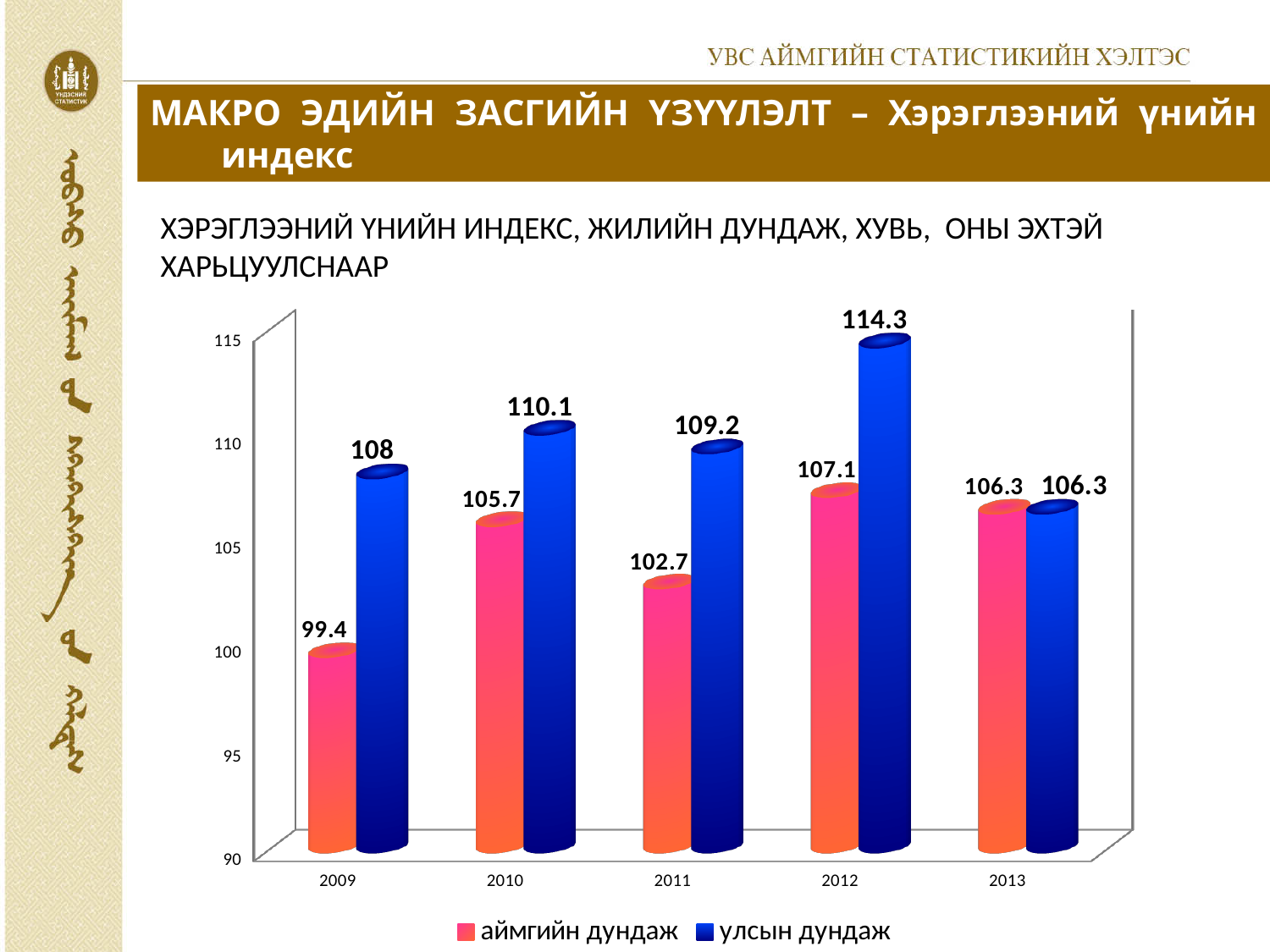
In which year is аймгийн дундаж lowest? 2009 How many years are shown on the x axis? 5 What is the difference between улсын дундаж in 2012 and улсын дундаж in 2013? 8 What is the difference between улсын дундаж and аймгийн дундаж in 2009? 8.6 What is the value for аймгийн дундаж in 2009? 99.4 How many series does the legend list? 2 In which year is улсын дундаж highest? 2012 What is the value for улсын дундаж in 2012? 114.3 Which series is shown in blue in the legend? улсын дундаж What kind of chart is shown on the slide? bar chart What is the value for аймгийн дундаж in 2011? 102.7 Which is larger in 2010: аймгийн дундаж or улсын дундаж? улсын дундаж